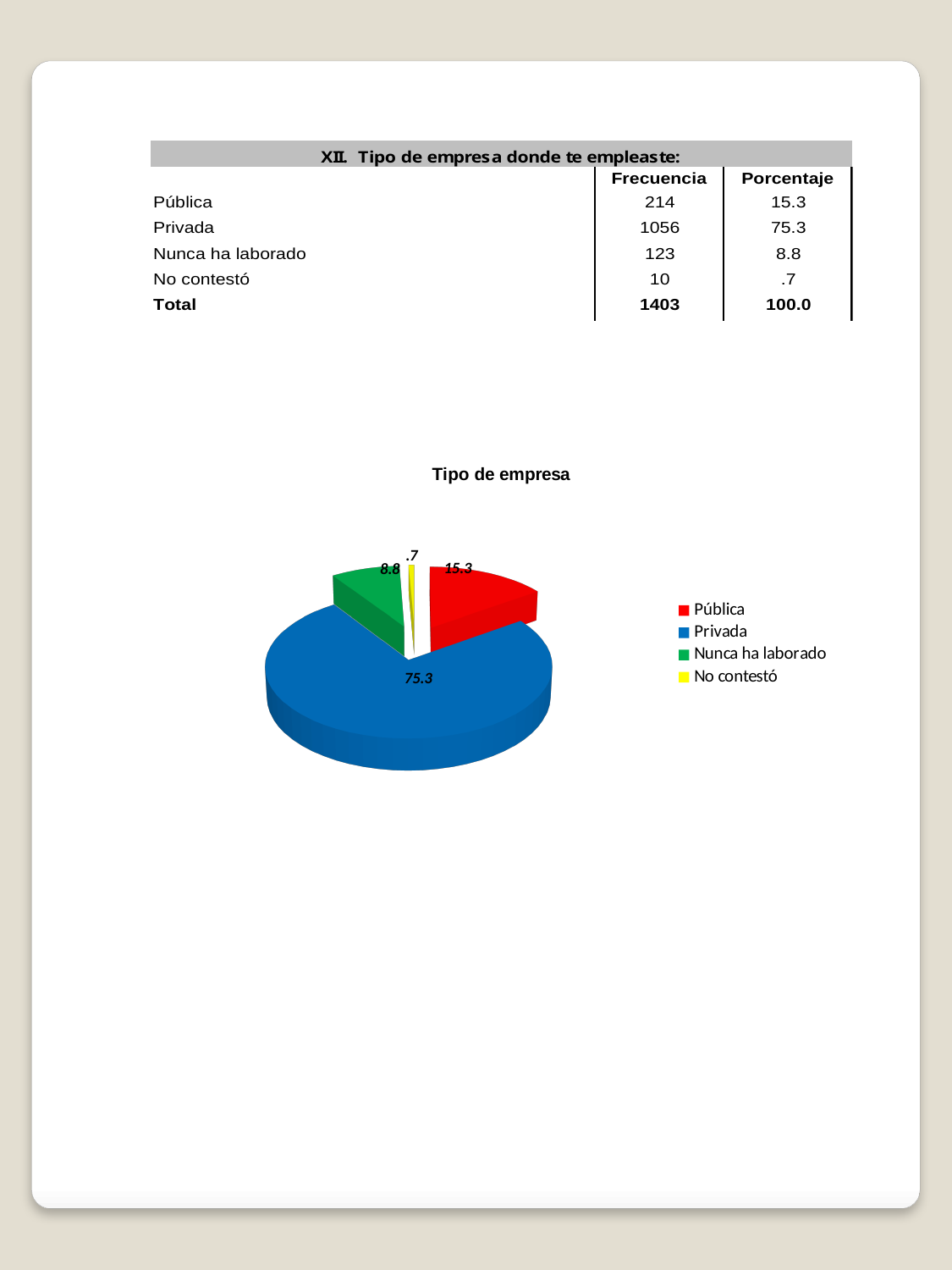
What is the title of the chart? Tipo de empresa What value is shown for the Privada slice? 75.3 Which is larger, the Pública slice or the Nunca ha laborado slice? Pública What colour is the Privada slice? blue What type of chart is shown on the slide? pie chart Which category has the smallest slice of the pie? No contestó What is the difference between the Privada and Pública values? 60.0 What value is shown for the Pública slice? 15.3 How many categories does the legend list? 4 What value is shown for the No contestó slice? .7 What value is shown for the Nunca ha laborado slice? 8.8 Which category has the largest slice of the pie? Privada